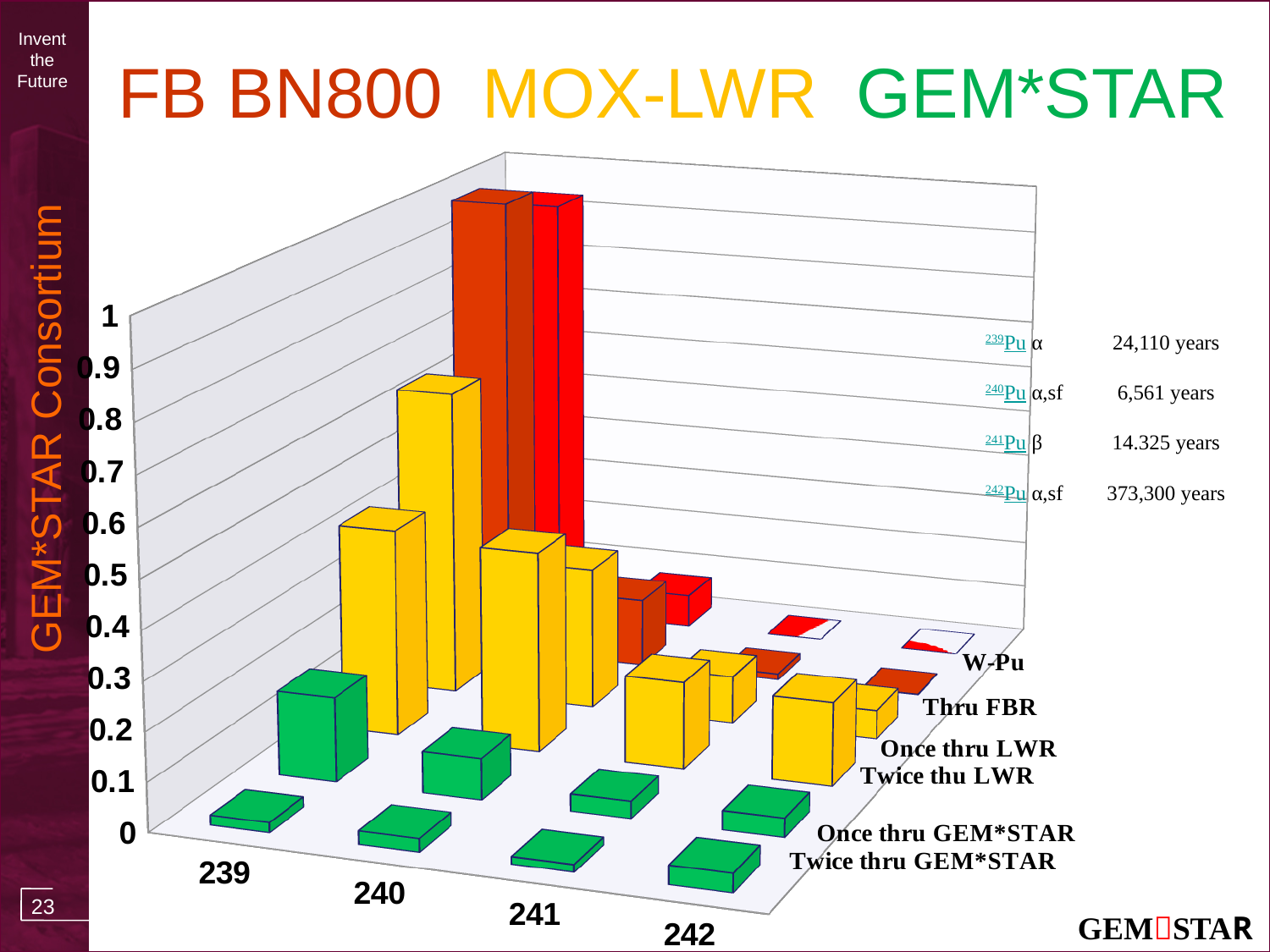
For the Once thru LWR series, which isotope has the highest bar? 239 Is the value for Twice thru GEM*STAR at 239 greater or less than 0.1? less What kind of chart is shown on the slide? bar chart How many isotope categories are shown along the x axis? 4 What colour are the bars for the GEM*STAR series? green For the W-Pu series, which isotope has the highest bar? 239 Which is larger for the W-Pu series: the value at 239 or the value at 240? 239 How many fuel-cycle series (rows) are plotted in the chart? 6 For the Once thru GEM*STAR series, which isotope has the highest bar? 239 Do the W-Pu values rise or fall from 239 to 242? fall Is the value for W-Pu at 242 greater or less than 0.1? less Is the value for W-Pu at 239 greater or less than 0.5? greater